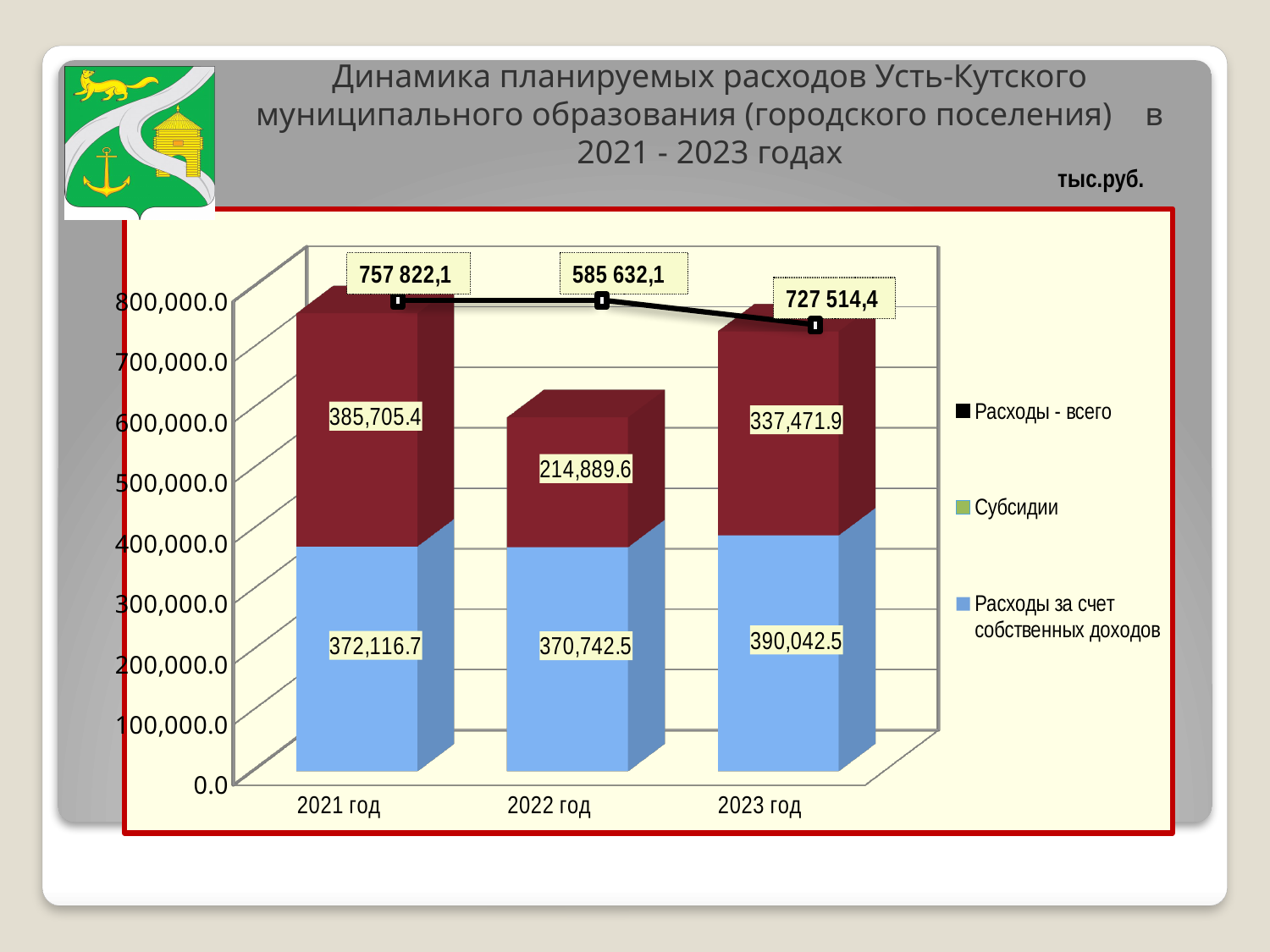
What is the value of Расходы за счет собственных доходов for 2021 год? 372,116.7 Is the upper (dark red) segment larger in 2021 год or in 2023 год? 2021 год Which year has the highest value of Расходы - всего? 2021 год Which year has the lowest value of Расходы - всего? 2022 год How many years are shown on the x axis? 3 What unit is indicated above the chart? тыс.руб. How many series does the legend list? 3 What is the difference between Расходы за счет собственных доходов in 2023 год and 2022 год? 19,300.0 Which year has the highest value of Расходы за счет собственных доходов? 2023 год What is the value of Расходы - всего for 2023 год? 727 514,4 What is the value of the upper (dark red) segment for 2022 год? 214,889.6 What kind of chart is this? Stacked bar chart with a line